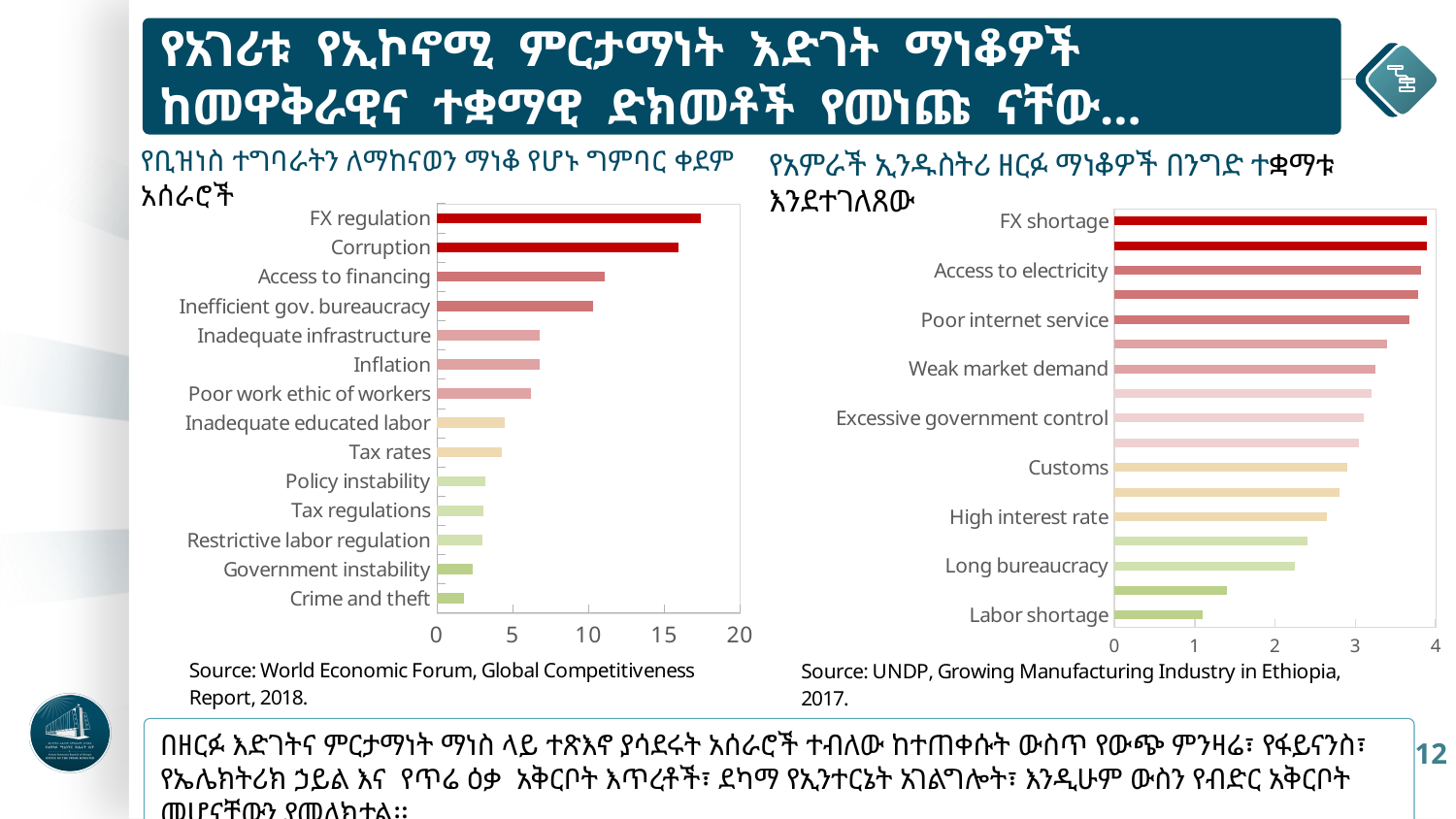
How many categories are shown in the chart on the left side of the slide? 14 In the chart on the right side of the slide, which is larger: Customs or High interest rate? Customs In the chart on the left side of the slide, which category has the lowest value? Crime and theft In the chart on the right side of the slide, which labeled category has the highest value? FX shortage In the chart on the left side of the slide, which is larger: Inadequate educated labor or Policy instability? Inadequate educated labor In the chart on the right side of the slide, which labeled category has the lowest value? Labor shortage In the chart on the left side of the slide, is the value for Corruption greater or less than 15? greater What is the source cited below the chart on the left side of the slide? World Economic Forum, Global Competitiveness Report, 2018. In the chart on the left side of the slide, is the value for Access to financing greater or less than 10? greater In the chart on the left side of the slide, which category has the highest value? FX regulation What kind of chart is the chart on the left side of the slide? bar chart In the chart on the right side of the slide, is the value for Long bureaucracy greater or less than 2? greater